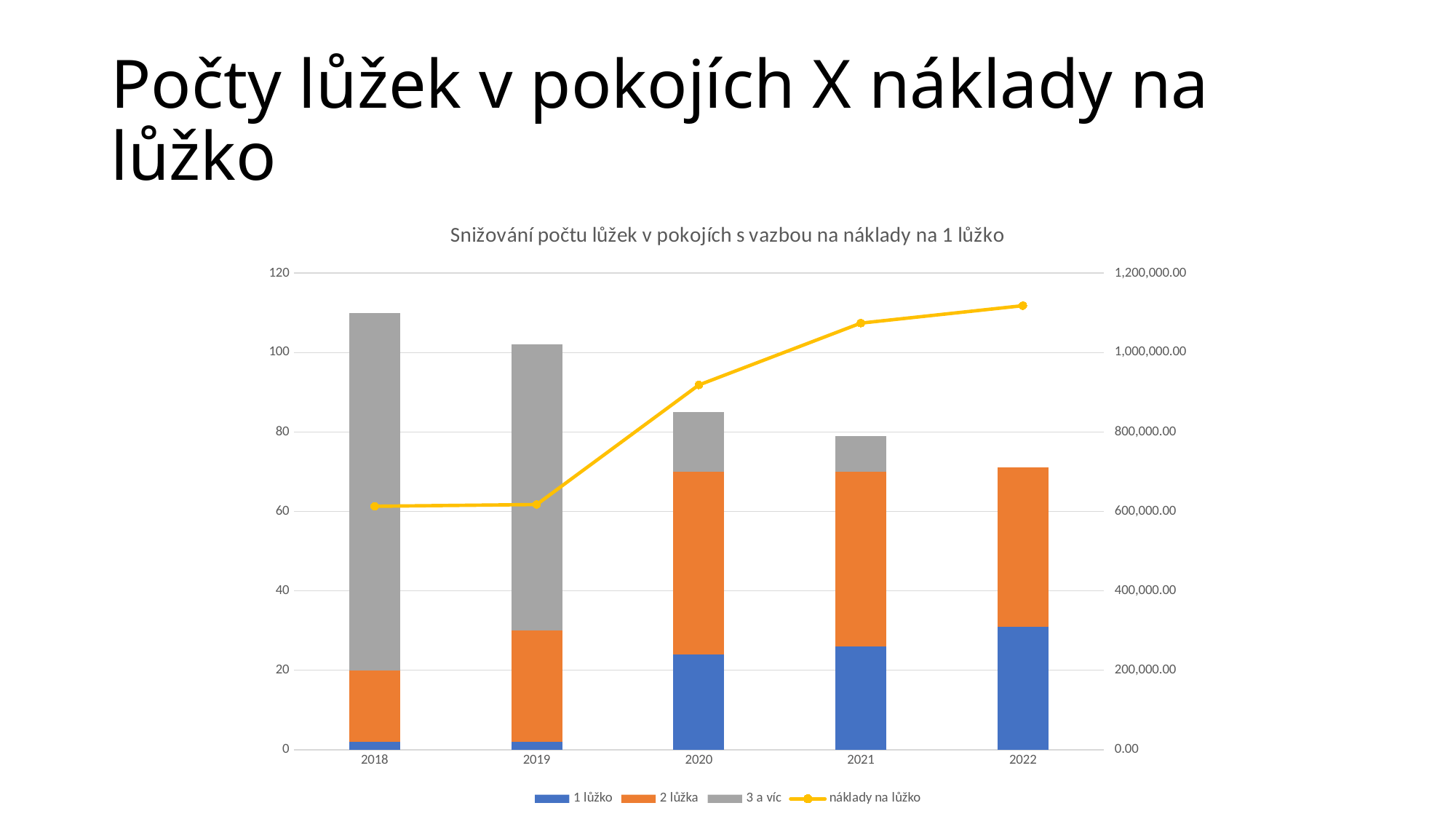
How many series does the legend list? 4 How many years are shown on the x axis? 5 Is the 'náklady na lůžko' value for 2022 greater or less than 1,000,000.00? greater Which year has the tallest stacked bar? 2018 Is the total height of the 2018 bar greater or less than 100? greater Does the 'náklady na lůžko' line rise or fall from 2018 to 2022? rises What kind of chart is this? Stacked bar chart with a line Is the 'náklady na lůžko' value for 2020 greater or less than 800,000.00? greater Which is larger, the '1 lůžko' segment in 2018 or in 2022? 2022 In which year is the 'náklady na lůžko' line at its highest? 2022 What is the title of the chart? Snižování počtu lůžek v pokojích s vazbou na náklady na 1 lůžko